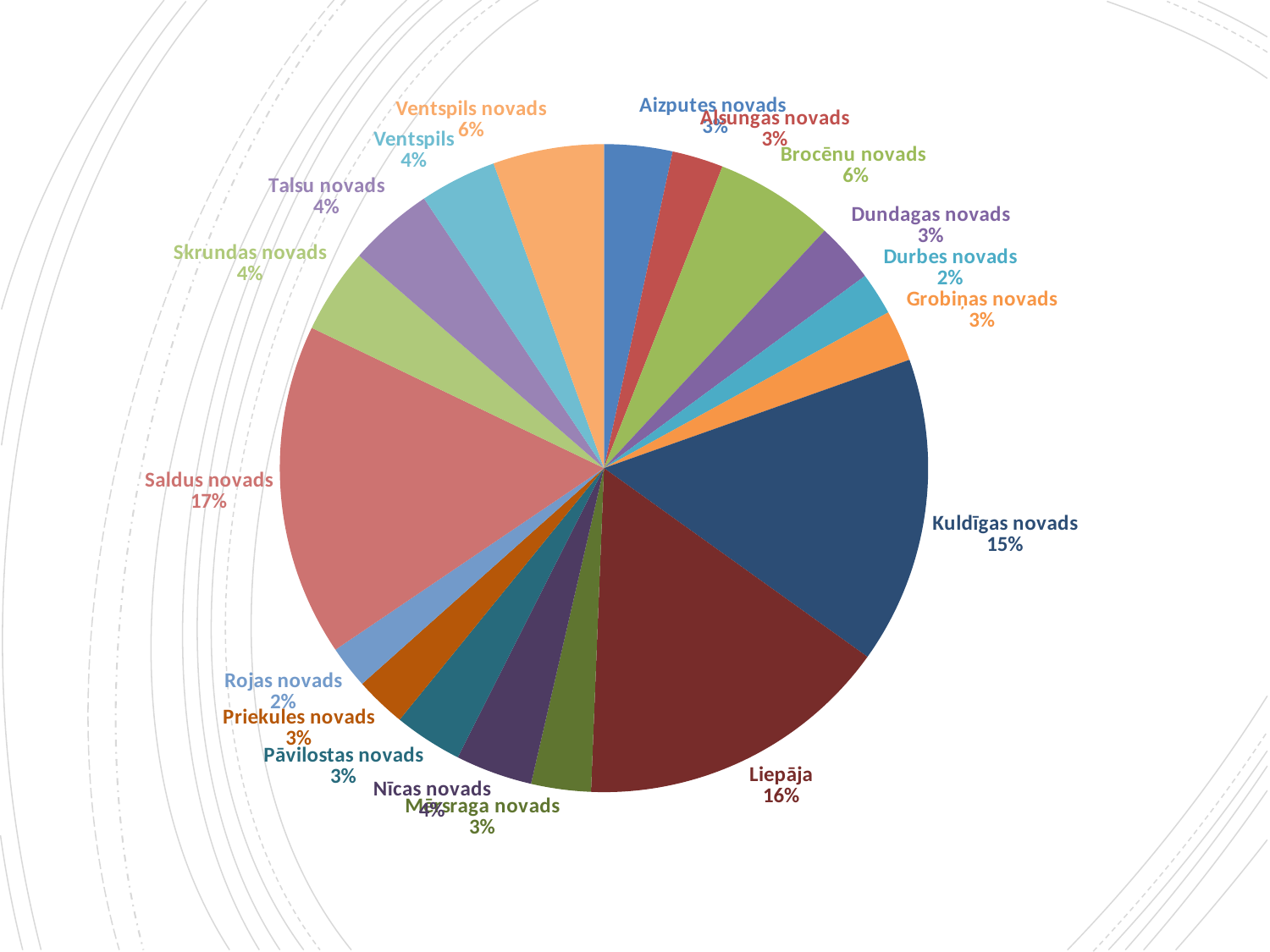
Which category has the largest slice of the pie? Saldus novads What is the value shown for Liepāja? 16% What is the value shown for Brocēnu novads? 6% What is the difference between the values for Ventspils novads and Ventspils? 2% What is the value shown for Durbes novads? 2% Which is larger, the slice for Kuldīgas novads or the slice for Brocēnu novads? Kuldīgas novads What is the difference between the values for Saldus novads and Liepāja? 1% What is the value shown for Talsu novads? 4% How many slices does the pie chart have? 18 What share of the pie does Kuldīgas novads have? 15% What kind of chart is shown on the slide? pie chart What share of the pie does Saldus novads have? 17%